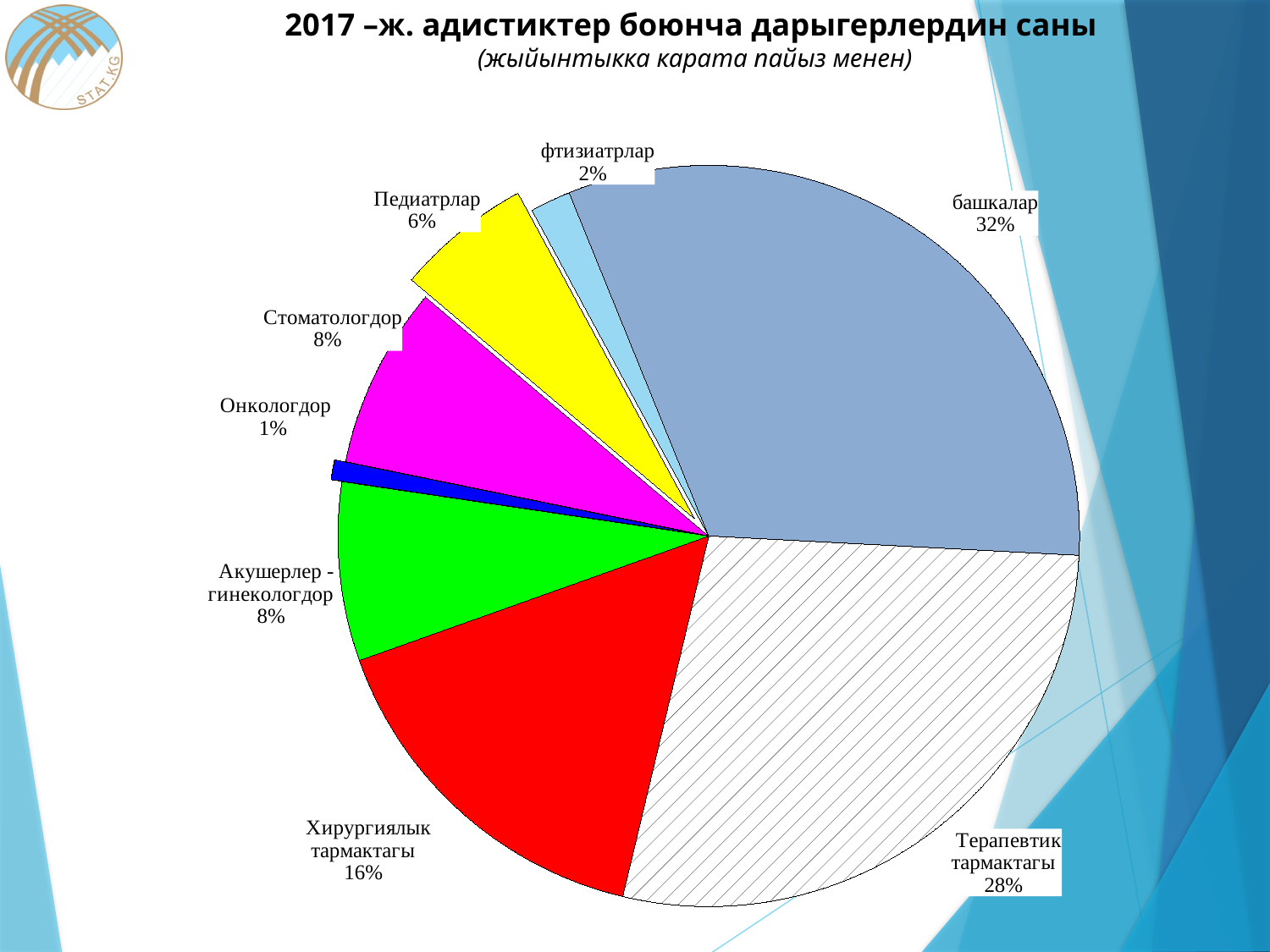
What year is mentioned in the chart title? 2017 What share of the pie does башкалар have? 32% What percentage is shown for Терапевтик тармактагы? 28% What percentage is shown for фтизиатрлар? 2% Which category has the largest share of the pie? башкалар Which category has the smallest share of the pie? Онкологдор What kind of chart is shown on the slide? pie chart Which is larger, the share for Хирургиялык тармактагы or the share for Стоматологдор? Хирургиялык тармактагы What percentage is shown for Хирургиялык тармактагы? 16% What is the difference in percentage points between башкалар and Терапевтик тармактагы? 4 What percentage is shown for Педиатрлар? 6% How many slices does the pie chart have? 8